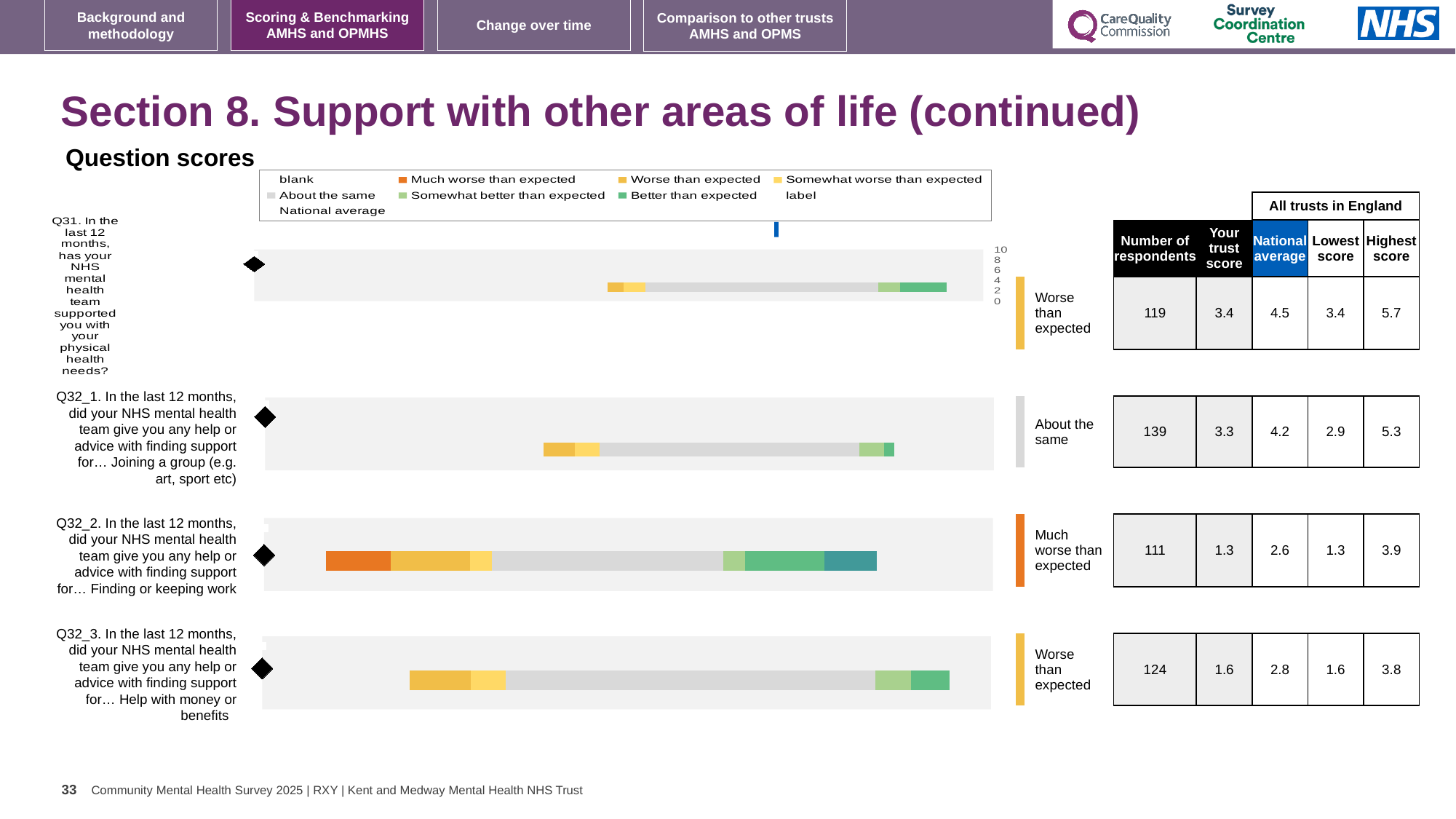
Which question has the lowest trust score? Q32_2 (finding or keeping work) Which question has the highest number of respondents? Q32_1 (joining a group) What benchmark category is shown for Q32_1 (joining a group)? About the same What is the highest score among all trusts in England for Q32_3 (help with money or benefits)? 3.8 Is the trust score for Q31 higher or lower than the national average for Q31? lower What is the trust score for Q31 (support with physical health needs)? 3.4 What is the national average for Q32_1 (help with joining a group)? 4.2 How many question charts are shown on the slide? 4 What benchmark category is shown for Q32_2 (finding or keeping work)? Much worse than expected How many respondents answered Q32_2 (help with finding or keeping work)? 111 What kind of chart is used to show each question score? Horizontal stacked bar chart What is the difference between the national average and the trust score for Q32_2 (finding or keeping work)? 1.3